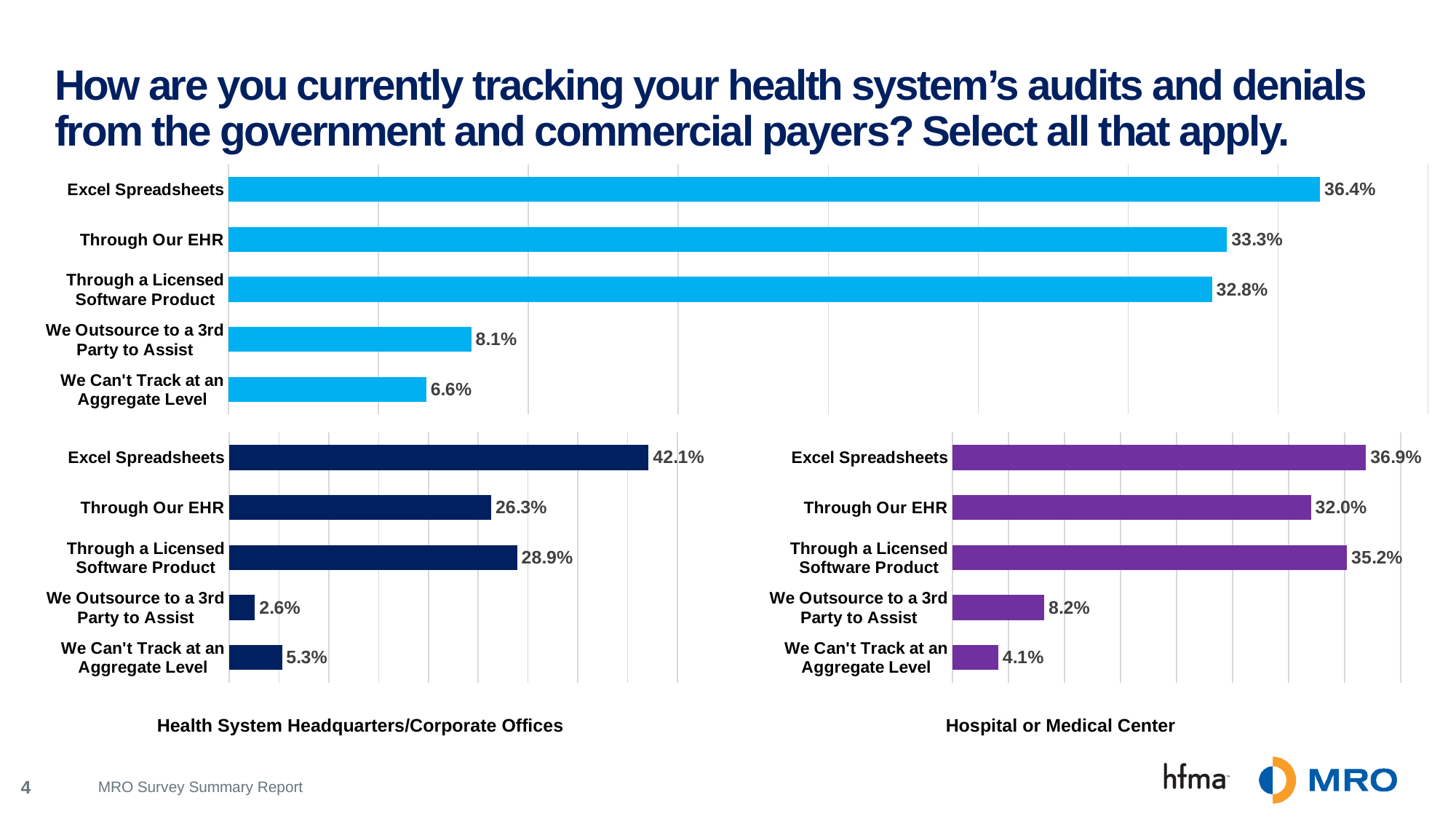
In the Hospital or Medical Center chart, what is the value for We Outsource to a 3rd Party to Assist? 8.2% What colour are the bars in the Hospital or Medical Center chart? Purple How many categories does the Hospital or Medical Center chart show? 5 In the Hospital or Medical Center chart, which category has the lowest value? We Can't Track at an Aggregate Level In the Health System Headquarters/Corporate Offices chart, what is the value for Through a Licensed Software Product? 28.9% In the Hospital or Medical Center chart, which is larger: Through Our EHR or Through a Licensed Software Product? Through a Licensed Software Product In the top chart, what is the value for We Can't Track at an Aggregate Level? 6.6% In the Health System Headquarters/Corporate Offices chart, which category has the lowest value? We Outsource to a 3rd Party to Assist In the top chart, what is the difference between Excel Spreadsheets and Through Our EHR? 3.1% In the Health System Headquarters/Corporate Offices chart, which category has the highest value? Excel Spreadsheets In the top chart, what is the value for Excel Spreadsheets? 36.4% What type of chart is the top chart? Bar chart